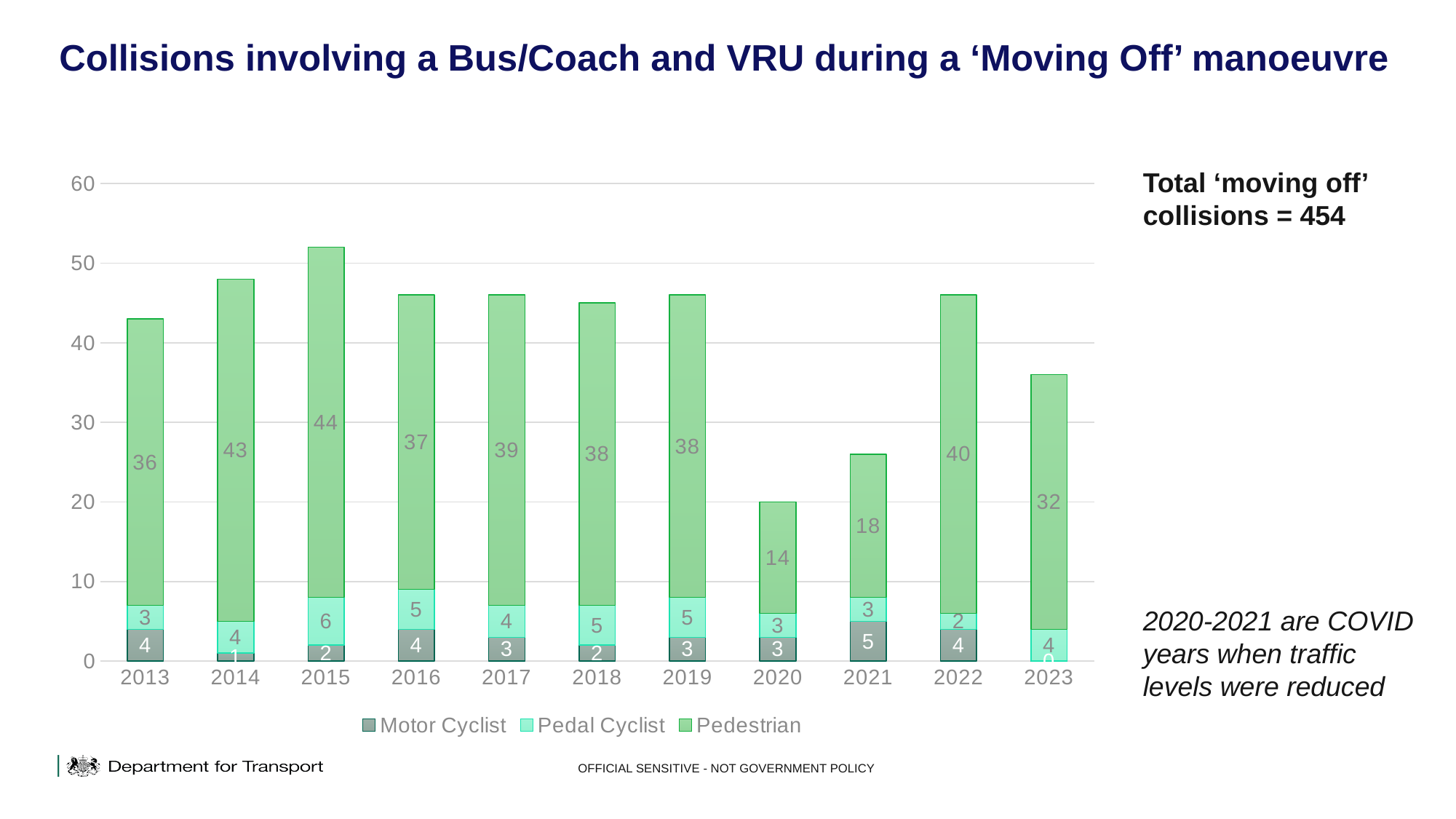
What is the Pedestrian value for 2015? 44 Which year has the lowest Pedestrian value? 2020 What is the Pedal Cyclist value for 2022? 2 How many series does the legend list? 3 What is the Motor Cyclist value for 2021? 5 Is the total height of the 2015 bar greater or less than 50? greater What is the difference between the Pedestrian values for 2014 and 2020? 29 How many years are shown on the x axis? 11 Which year has the highest Pedestrian value? 2015 Which is larger, the Pedal Cyclist value for 2015 or for 2019? 2015 What kind of chart is shown on the slide? Stacked bar chart What is the total of the stacked bar for 2020? 20